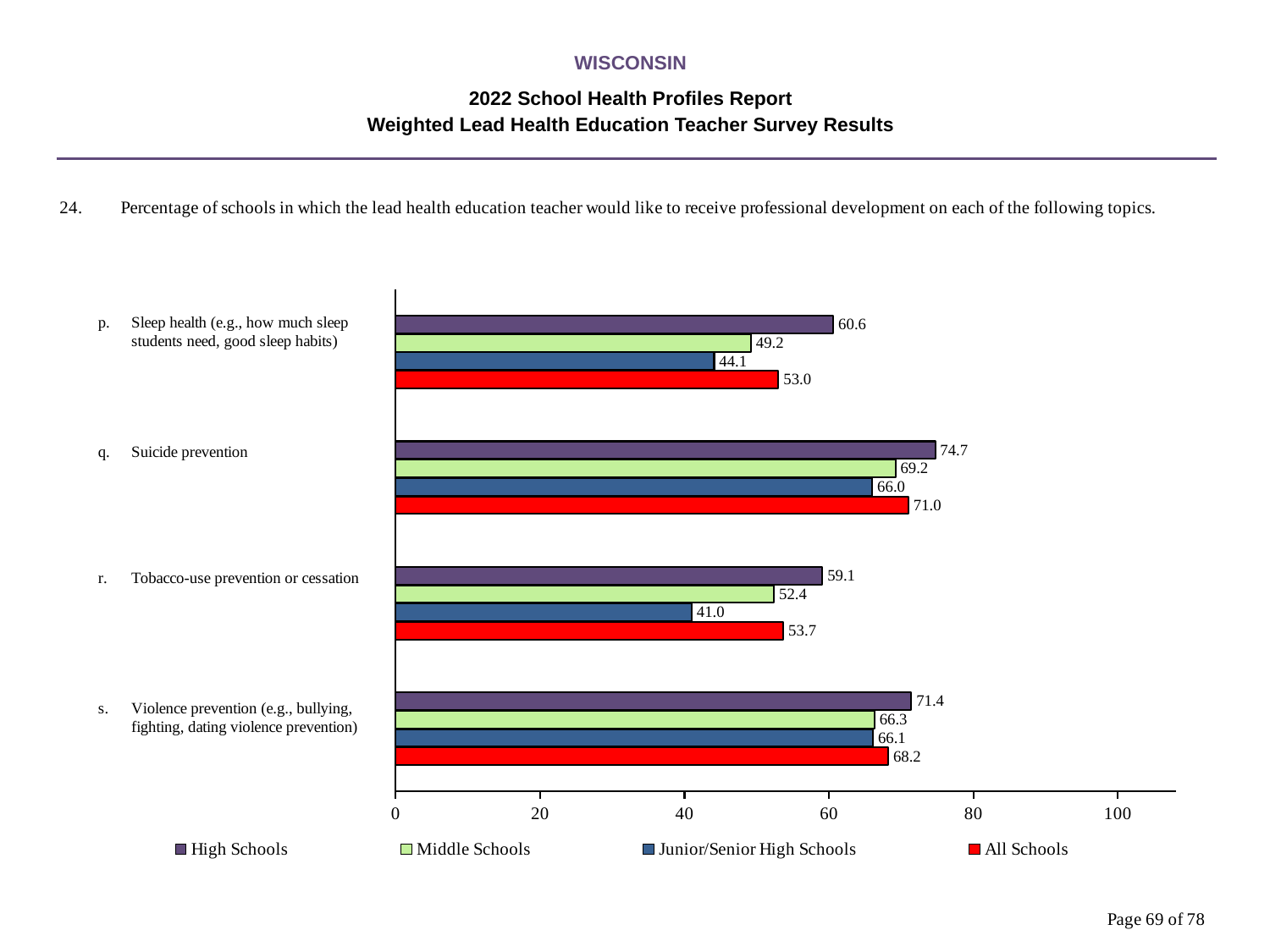
What is the value for Junior/Senior High Schools for Tobacco-use prevention or cessation? 41.0 Which is larger for Suicide prevention: the All Schools value or the Middle Schools value? All Schools Which topic has the lowest value for Junior/Senior High Schools? Tobacco-use prevention or cessation What colour represents All Schools in the legend? Red What kind of chart is shown on the slide? Bar chart What is the difference between the High Schools and Middle Schools values for Sleep health? 11.4 What is the value for High Schools for Suicide prevention? 74.7 What is the value for Middle Schools for Violence prevention? 66.3 Which topic has the highest value for High Schools? Suicide prevention How many topics are shown on the chart? 4 What is the value for All Schools for Sleep health? 53.0 How many series does the legend list? 4